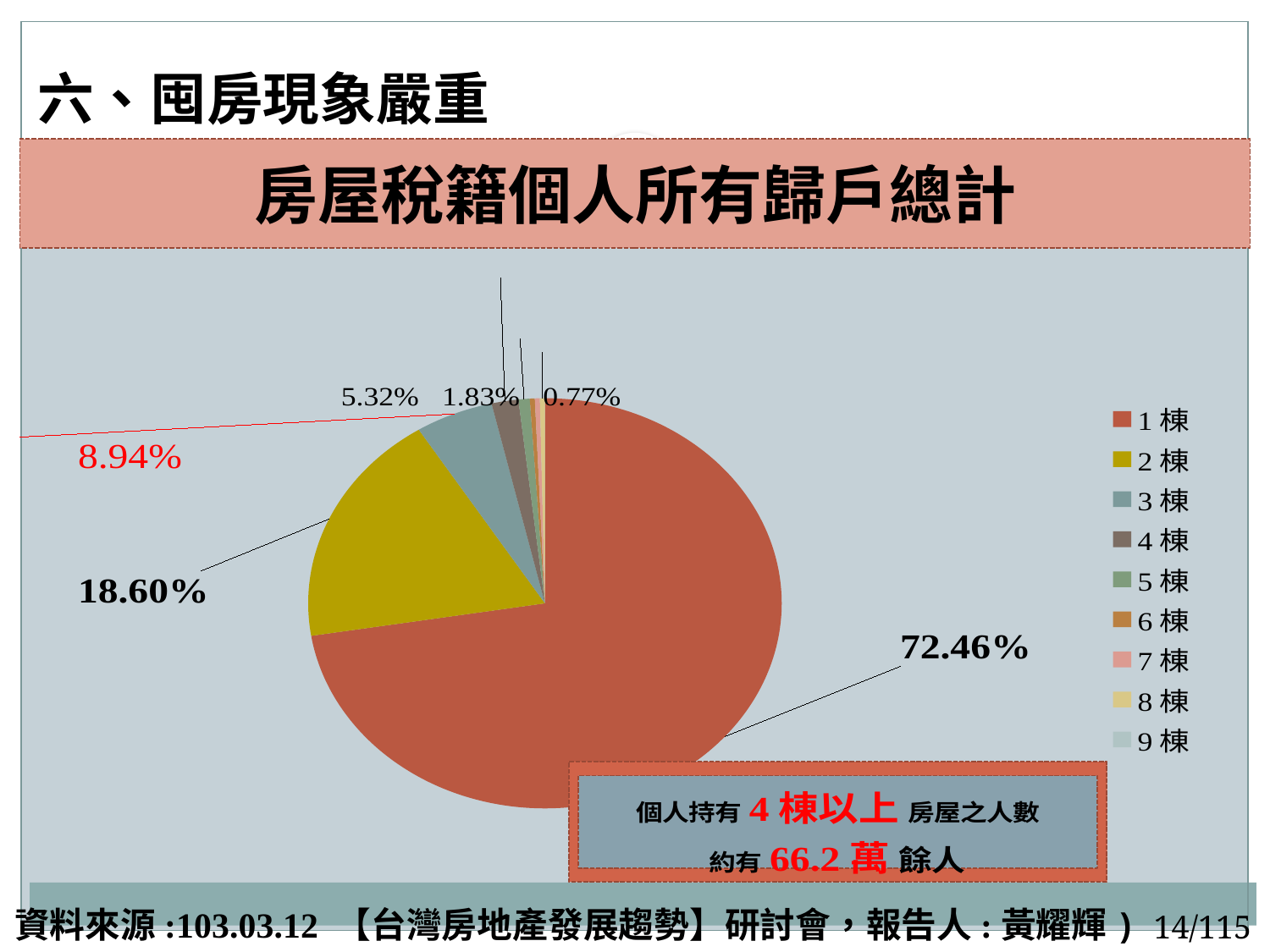
What percentage is shown for the 2 棟 slice? 18.60% What kind of chart is shown on the slide? pie chart How many categories does the legend list? 9 What is the title of the chart? 房屋稅籍個人所有歸戶總計 What is the difference in percentage points between the 1 棟 slice and the 2 棟 slice? 53.86% What percentage of the pie is the 1 棟 slice? 72.46% Which category has the largest slice of the pie? 1 棟 Which slice is larger, 2 棟 or 3 棟? 2 棟 What percentage is shown for the 3 棟 slice? 5.32% What percentage is shown for the 4 棟 slice? 1.83% What is the difference in percentage points between the 2 棟 slice and the 3 棟 slice? 13.28% According to the text box on the chart, about how many people own 4 or more houses? 約有 66.2 萬餘人